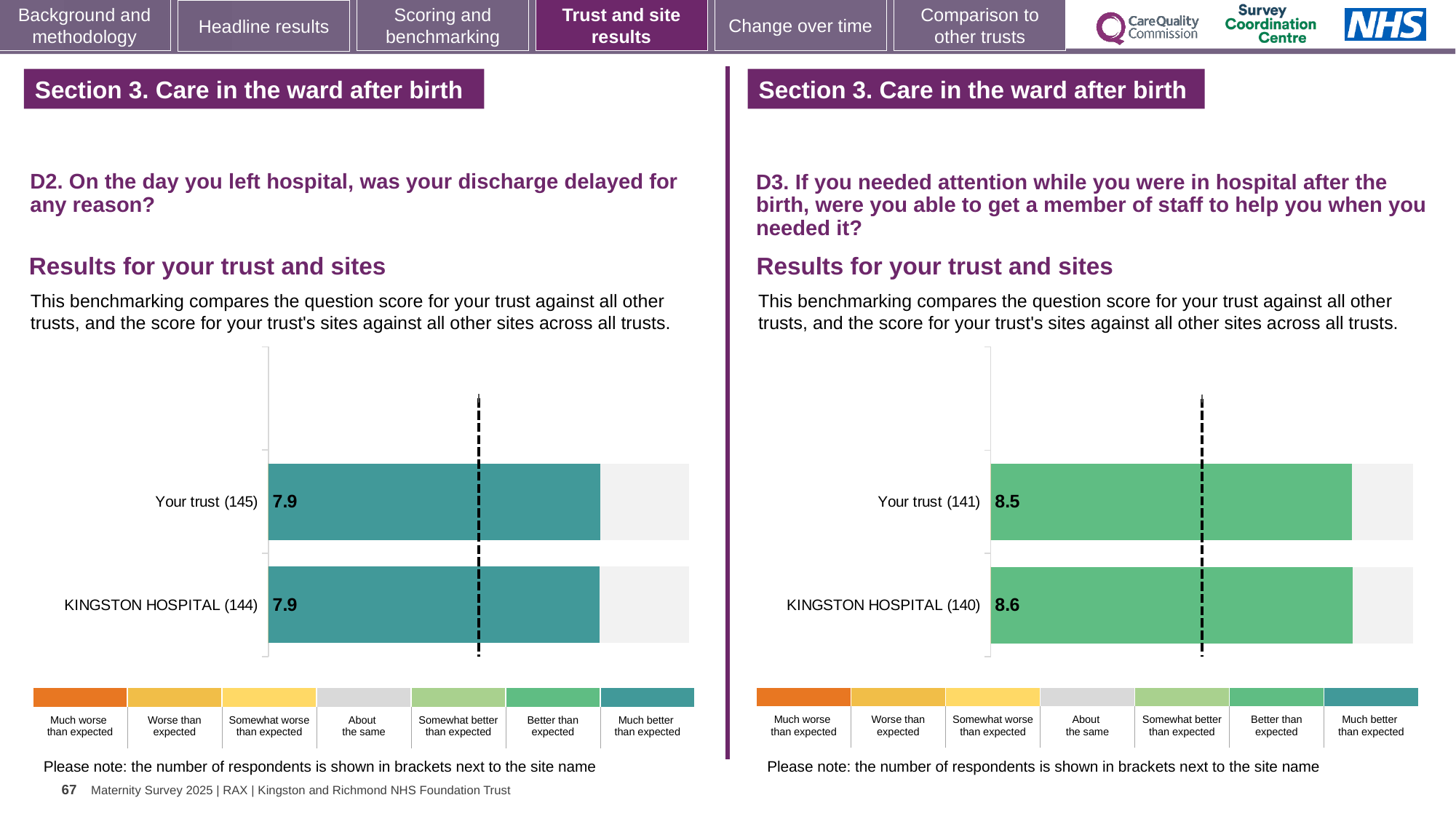
On the right chart (D3), what is the score for Your trust? 8.5 On the left chart (D2), what is the score for KINGSTON HOSPITAL? 7.9 On the left chart (D2), how many respondents are shown in brackets for Your trust? 145 On the right chart (D3), what is the score for KINGSTON HOSPITAL? 8.6 What kind of chart is shown on the left (D2)? Bar chart On the left chart (D2), what is the difference between the Your trust score and the KINGSTON HOSPITAL score? 0 On the right chart (D3), how many bars are plotted? 2 On the right chart (D3), which benchmark category does the colour of the bars correspond to in the legend? Better than expected On the left chart (D2), what is the score for Your trust? 7.9 On the left chart (D2), which benchmark category does the colour of the bars correspond to in the legend? Much better than expected On the right chart (D3), what is the difference between the KINGSTON HOSPITAL score and the Your trust score? 0.1 On the right chart (D3), how many respondents are shown in brackets for KINGSTON HOSPITAL? 140